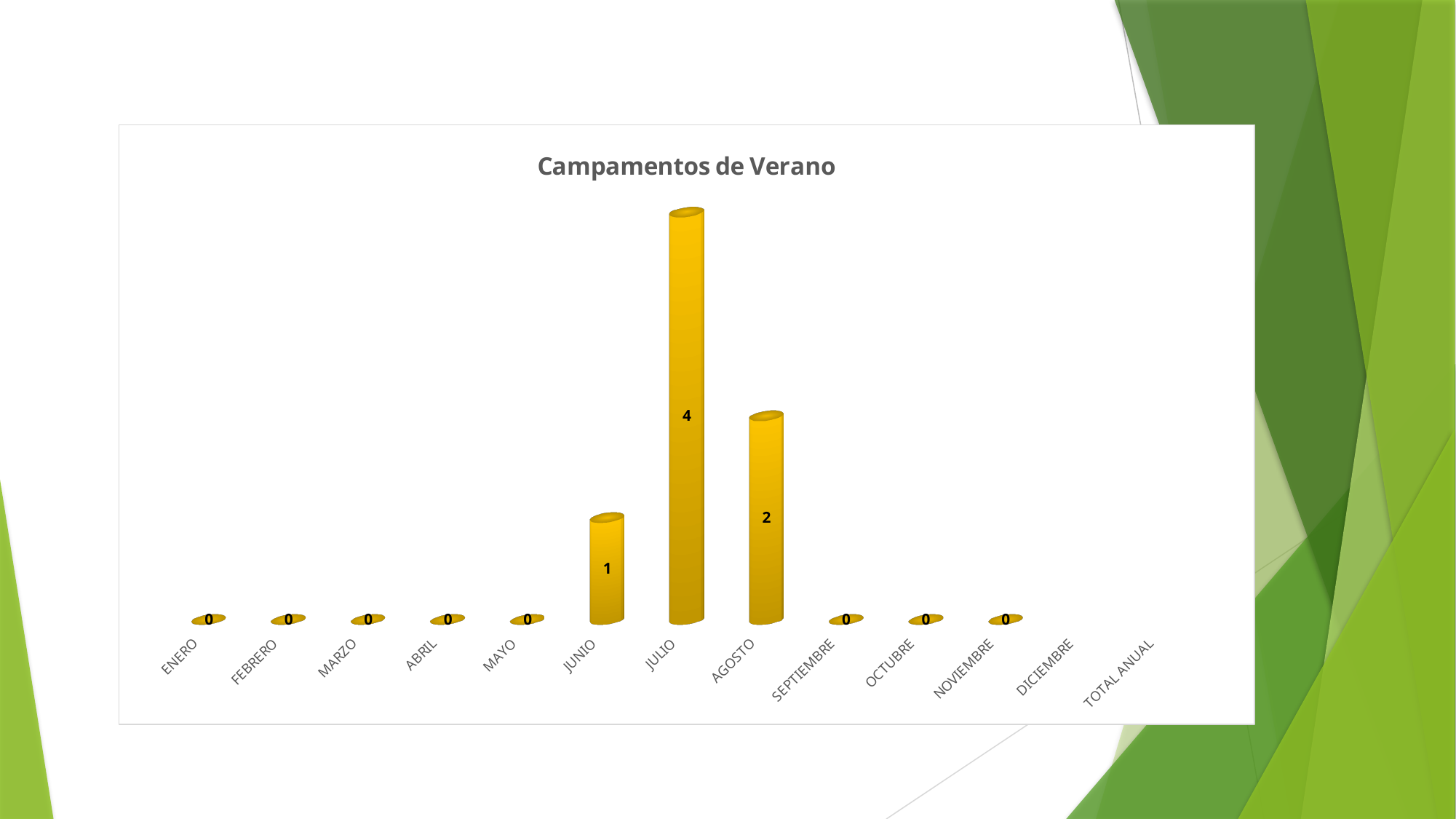
What is the value for JULIO in the Campamentos de Verano chart? 4 What is the value for MARZO in the Campamentos de Verano chart? 0 How many category labels appear along the x axis of the chart? 13 What kind of chart is shown on the slide? Bar chart What is the value for JUNIO in the Campamentos de Verano chart? 1 Which is larger, the value for JUNIO or the value for AGOSTO? AGOSTO What is the value for AGOSTO in the Campamentos de Verano chart? 2 What is the difference between the values for AGOSTO and JUNIO? 1 What is the title of the chart? Campamentos de Verano Which month has the highest value in the Campamentos de Verano chart? JULIO What colour are the bars in the chart? Yellow/gold What is the difference between the values for JULIO and AGOSTO? 2